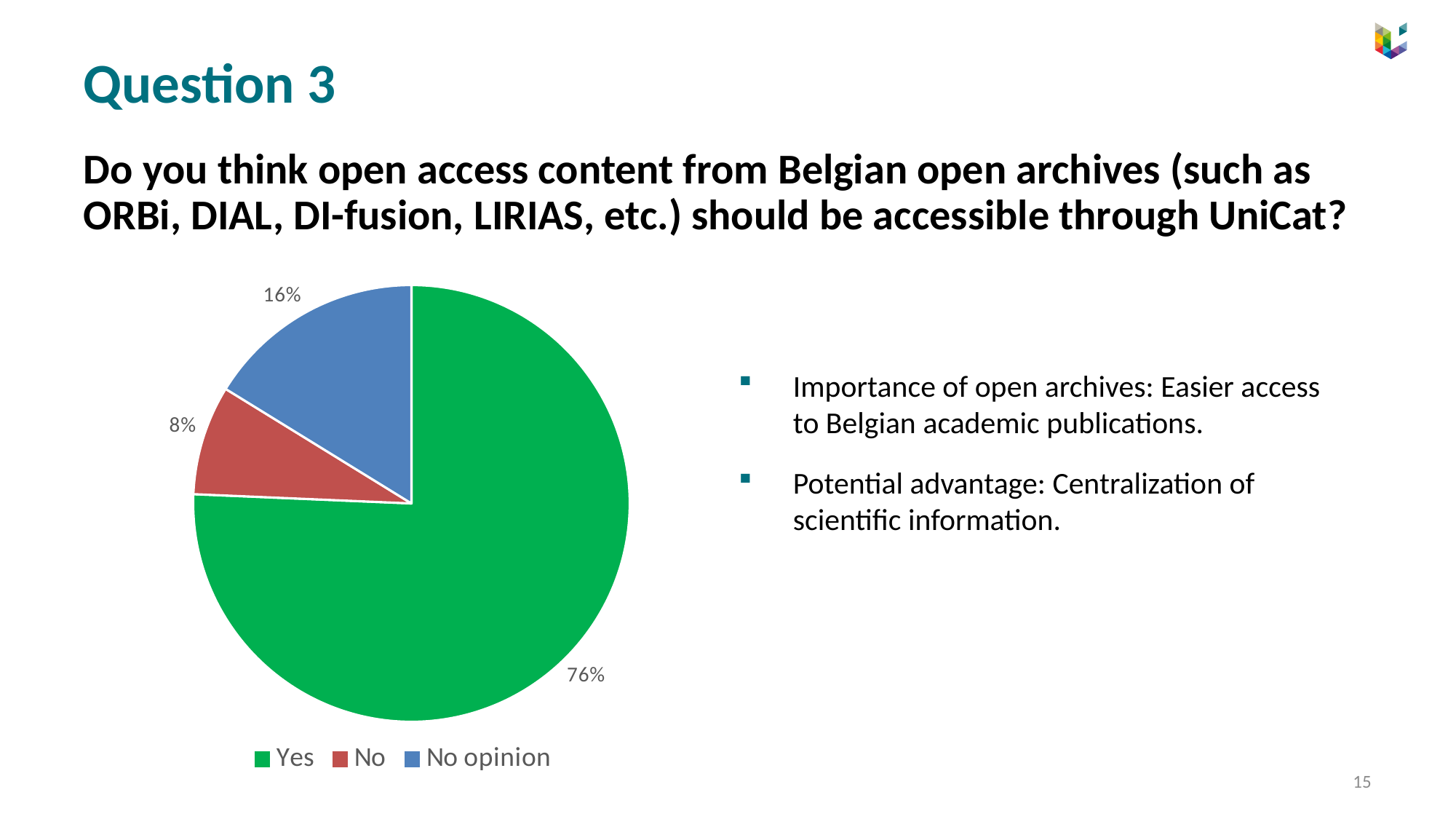
Which is larger, the share for No or the share for No opinion? No opinion Which response has the largest share of the pie? Yes What type of chart is shown on the slide? pie chart What is the difference in percentage points between No opinion and No? 8 What percentage of respondents answered No? 8% What percentage of respondents answered Yes? 76% How many slices does the pie chart have? 3 What percentage of respondents answered No opinion? 16% What is the difference in percentage points between Yes and No opinion? 60 What colour is the Yes slice? green How many entries does the legend list? 3 Which response has the smallest share of the pie? No